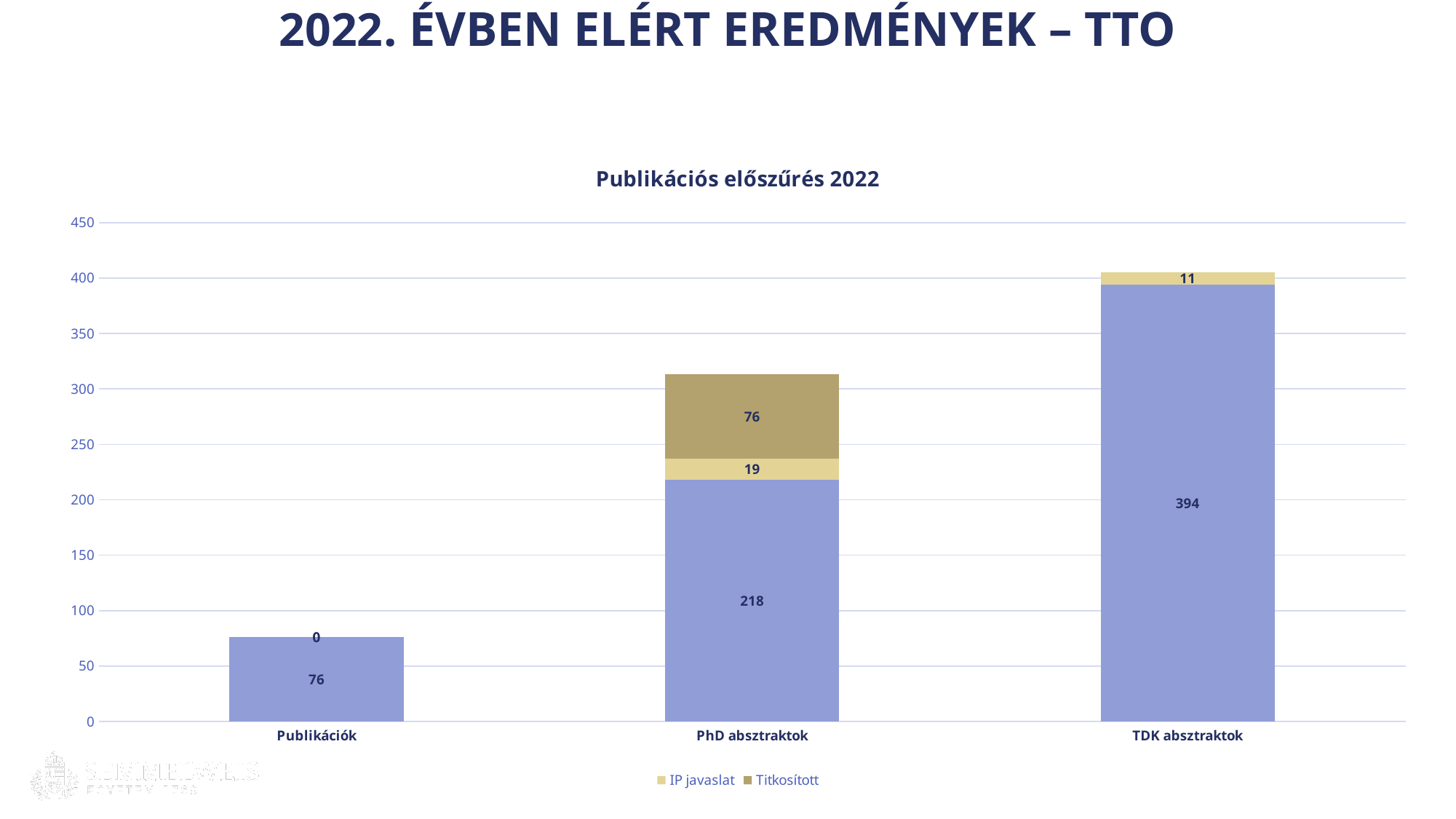
What is the title of the chart? Publikációs előszűrés 2022 What is the difference between the blue segment values for TDK absztraktok and PhD absztraktok? 176 How many categories are shown on the x axis of the chart? 3 Which category has the tallest stacked bar? TDK absztraktok How many series does the chart's legend list? 2 What is the value of the IP javaslat segment for TDK absztraktok? 11 What is the value of the Titkosított segment for PhD absztraktok? 76 What is the value of the blue segment for TDK absztraktok? 394 Which category has the shortest stacked bar? Publikációk What is the total of the stacked bar for PhD absztraktok? 313 What is the value of the IP javaslat segment for PhD absztraktok? 19 What kind of chart is shown on the slide? stacked bar chart